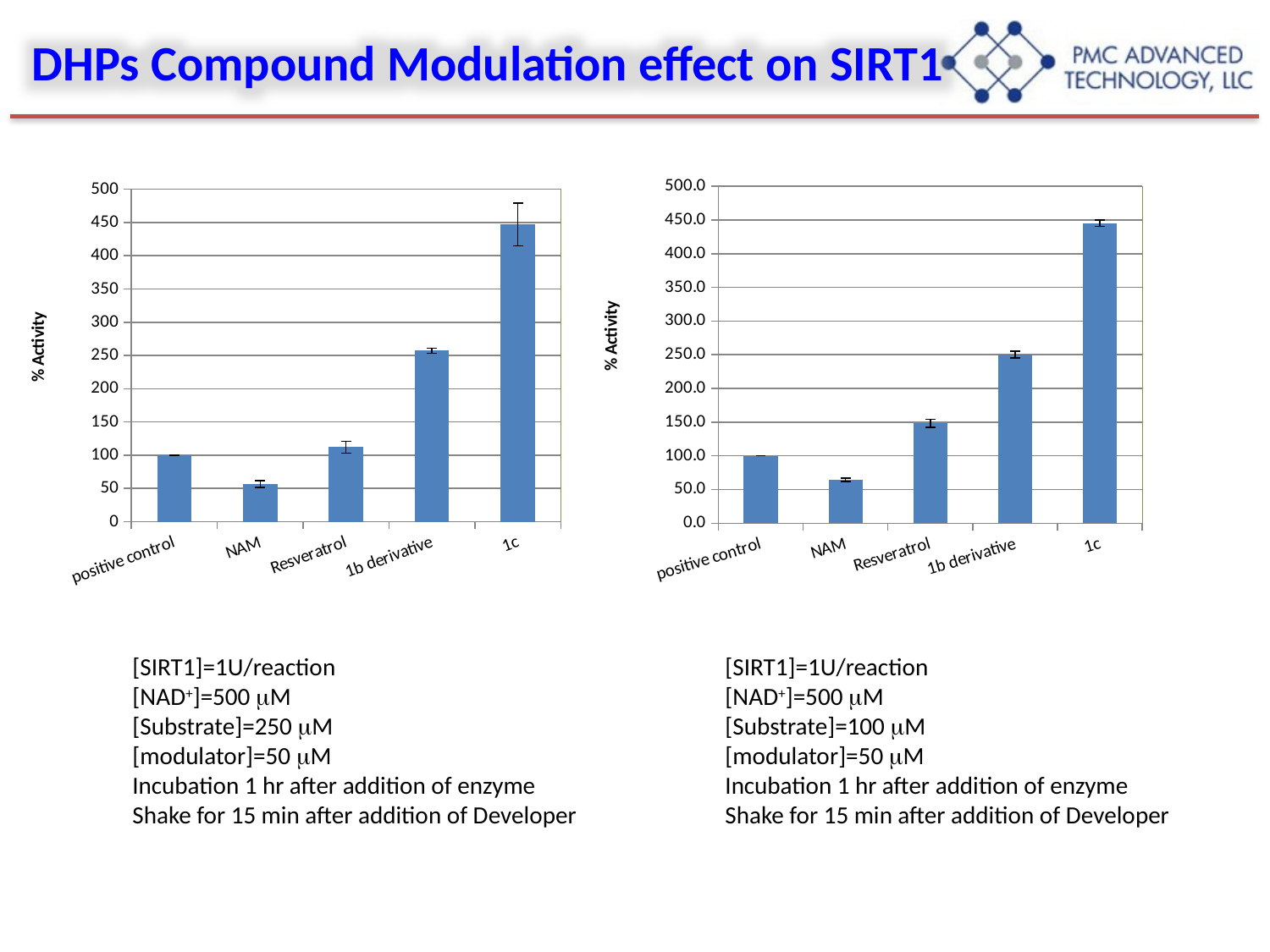
In the left chart, which category has the highest % Activity? 1c In the right chart, which category has the lowest % Activity? NAM What kind of chart is the right chart? bar chart In the right chart, which category has the highest % Activity? 1c In the right chart, is the value for 1c greater or less than 400.0? greater In the right chart, which is larger, the value for Resveratrol or the value for positive control? Resveratrol In the left chart, which is larger, the value for 1b derivative or the value for Resveratrol? 1b derivative In the left chart, is the value for 1c greater or less than 400? greater In the left chart, is the value for NAM greater or less than 100? less How many categories are shown on the x axis of the left chart? 5 In the left chart, which category has the lowest % Activity? NAM